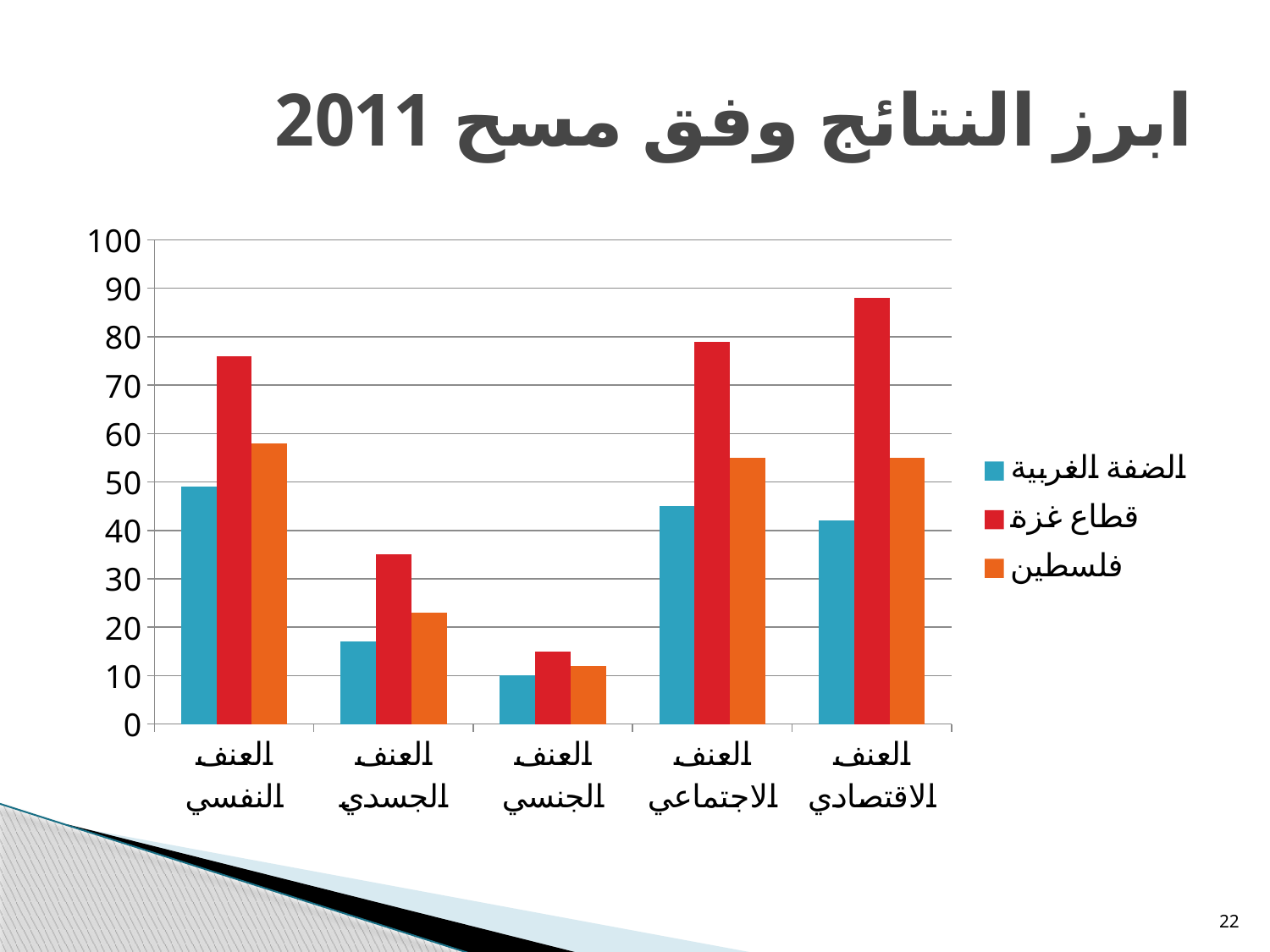
What is the title of the slide? ابرز النتائج وفق مسح 2011 Is the value for فلسطين in العنف النفسي greater or less than 50? greater What kind of chart is shown on the slide? bar chart Which category has the lowest value for الضفة الغربية? العنف الجنسي Is the value for الضفة الغربية in العنف الجسدي greater or less than 20? less Which series is shown in red? قطاع غزة Is the value for قطاع غزة in العنف الاقتصادي greater or less than 80? greater Which category has the lowest value for فلسطين? العنف الجنسي Which category has the highest value for قطاع غزة? العنف الاقتصادي How many series does the legend list? 3 How many categories are shown on the x axis? 5 Which is larger in العنف الاجتماعي: the value for قطاع غزة or the value for الضفة الغربية? قطاع غزة